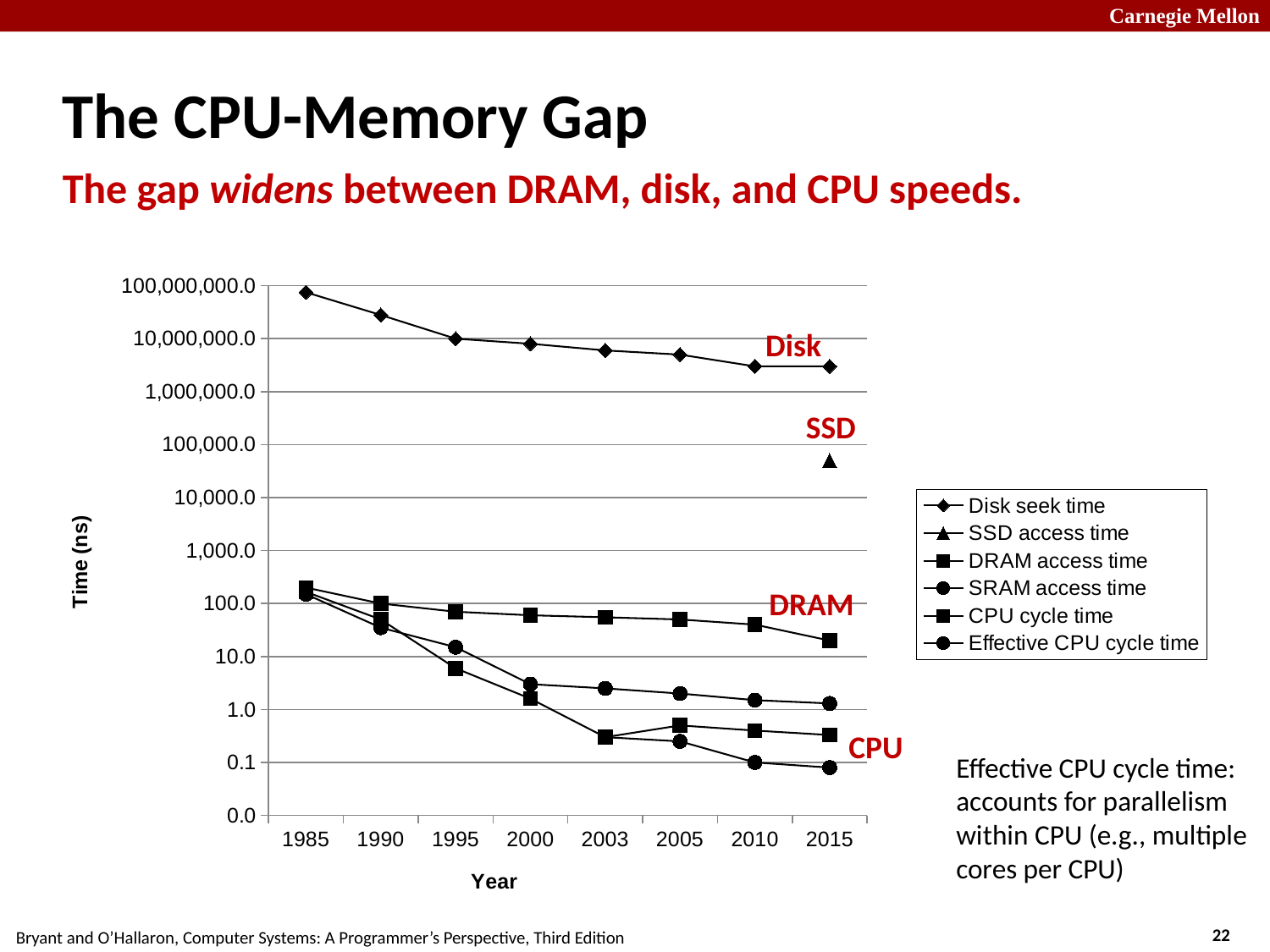
How many series does the legend list? 6 Does the Disk seek time rise or fall from 1985 to 2015? fall Is the Disk seek time in 1985 greater or less than 10,000,000.0? greater Is the DRAM access time in 2015 greater or less than 100.0? less Is the SSD access time in 2015 greater or less than 100,000.0? less What kind of chart is shown on the slide? line chart Which series has the lowest value in 2015? Effective CPU cycle time In 2015, which is larger: Disk seek time or DRAM access time? Disk seek time What is the title of the y axis? Time (ns) What is the title of the x axis? Year Which series has the highest value in 2015? Disk seek time How many years are plotted along the x axis? 8